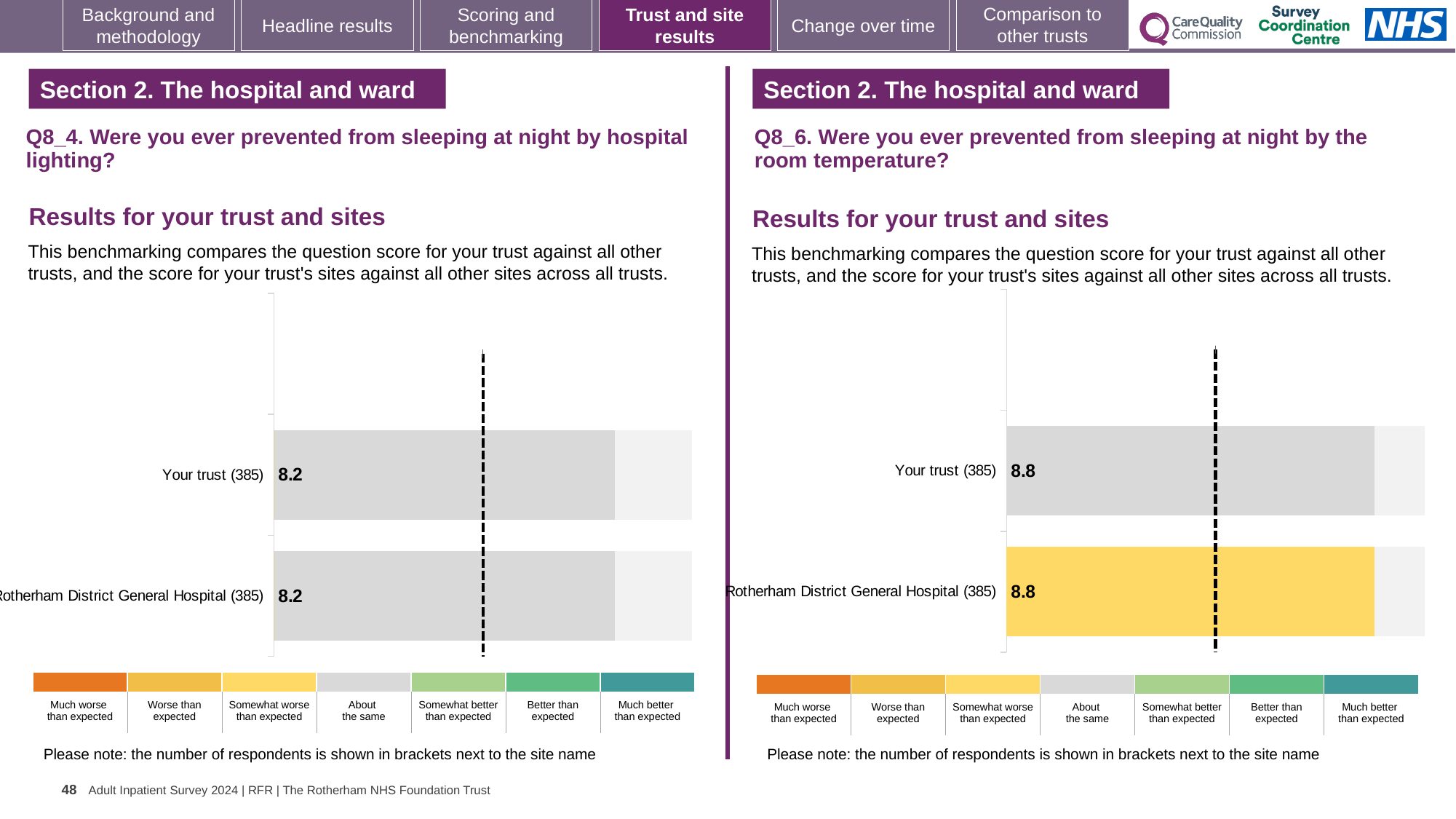
In the Q8_4 chart (hospital lighting) on the left, what is the score for Your trust (385)? 8.2 What kind of chart is used for the Q8_6 results on the right? Bar chart How many respondents are shown in brackets next to Your trust in the Q8_4 chart on the left? 385 Which is larger: the Rotherham District General Hospital score in the Q8_6 chart on the right or in the Q8_4 chart on the left? Q8_6 chart on the right In the Q8_6 chart on the right, what colour is the bar for Rotherham District General Hospital (385)? Yellow How many bars are plotted in the Q8_6 chart on the right? 2 How many bars are plotted in the Q8_4 chart on the left? 2 What is the difference between the Your trust score in the Q8_6 chart on the right and the Your trust score in the Q8_4 chart on the left? 0.6 In the Q8_4 chart on the left, what is the difference between the score for Your trust and the score for Rotherham District General Hospital? 0 In the Q8_6 chart (room temperature) on the right, what is the score for Your trust (385)? 8.8 In the Q8_6 chart (room temperature) on the right, what is the score for Rotherham District General Hospital (385)? 8.8 In the Q8_4 chart (hospital lighting) on the left, what is the score for Rotherham District General Hospital (385)? 8.2